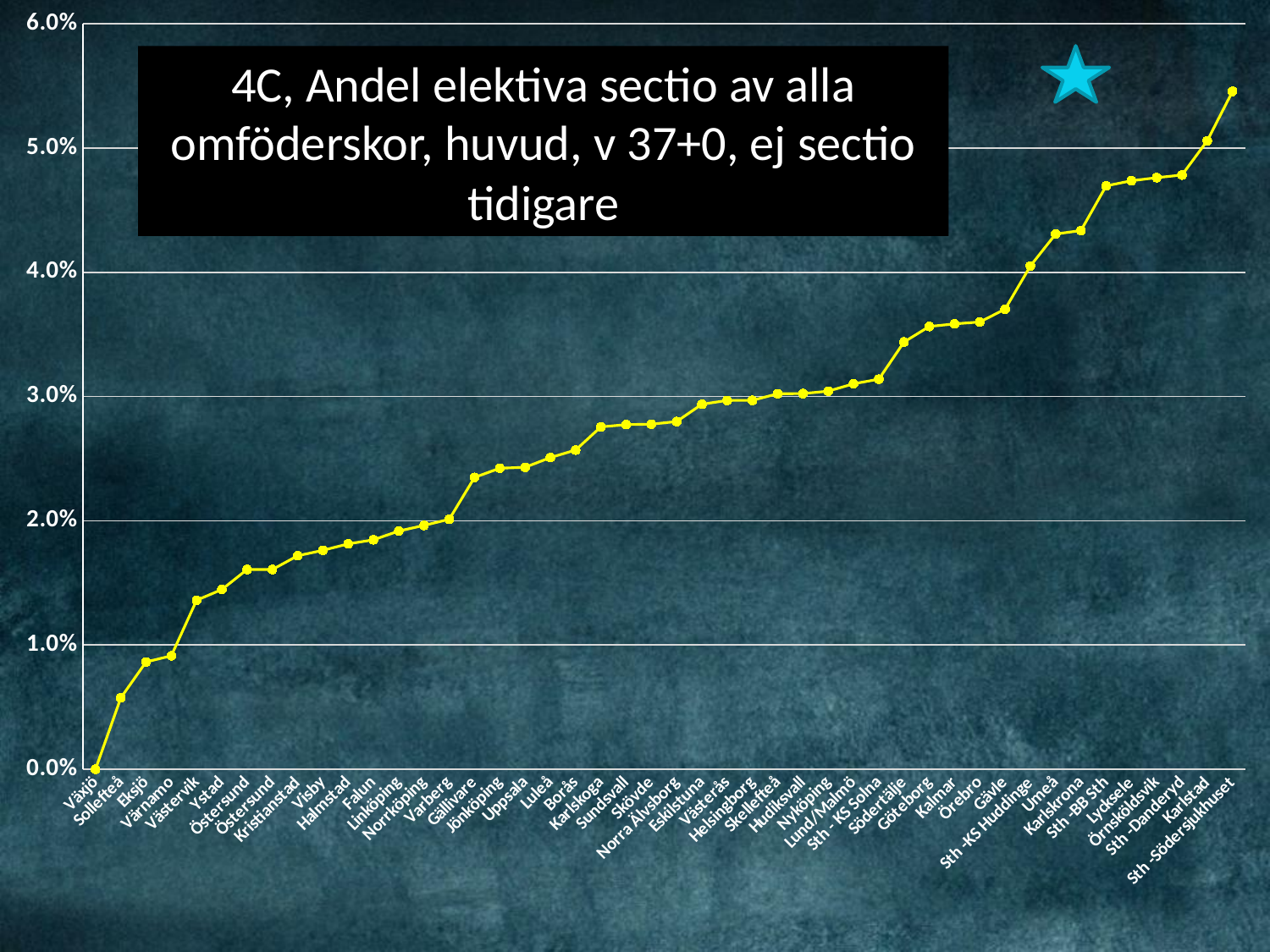
Is the value for Sth -Södersjukhuset greater or less than 5.0%? greater How many categories are plotted on the x axis? 46 What kind of chart is shown on the slide? line chart Which has the larger value, Umeå or Gävle? Umeå Which category has the lowest value? Växjö Is the value for Gällivare greater or less than 2.0%? greater Is the value for Eksjö greater or less than 1.0%? less What is the value for Växjö? 0.0% Do the values rise or fall from left to right along the x axis? rise Which category has the highest value? Sth -Södersjukhuset What is the title of the chart? 4C, Andel elektiva sectio av alla omföderskor, huvud, v 37+0, ej sectio tidigare